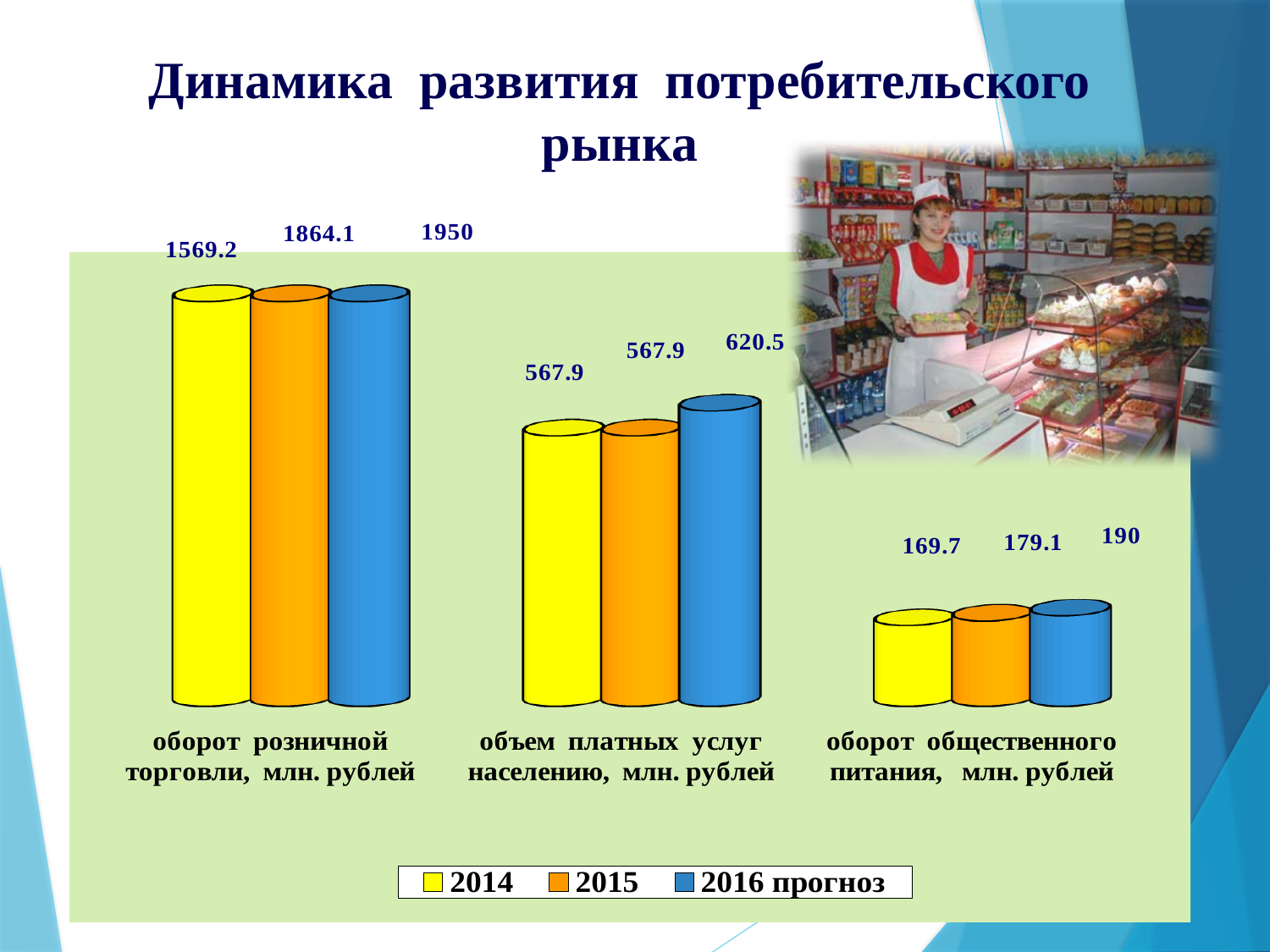
Which category has the lowest 2014 value? оборот общественного питания, млн. рублей What is the 2014 value for оборот розничной торговли, млн. рублей? 1569.2 What is the 2015 value for объем платных услуг населению, млн. рублей? 567.9 Which category has the highest 2016 прогноз value? оборот розничной торговли, млн. рублей What is the 2016 прогноз value for оборот общественного питания, млн. рублей? 190 What is the difference between the 2016 прогноз and 2015 values for оборот общественного питания, млн. рублей? 10.9 What is the 2016 прогноз value for объем платных услуг населению, млн. рублей? 620.5 What is the difference between the 2015 and 2014 values for оборот розничной торговли, млн. рублей? 294.9 What kind of chart is shown on the slide? bar chart How many series does the legend list? 3 How many categories are shown on the x axis? 3 Which is larger for объем платных услуг населению: the 2016 прогноз value or the 2014 value? 2016 прогноз